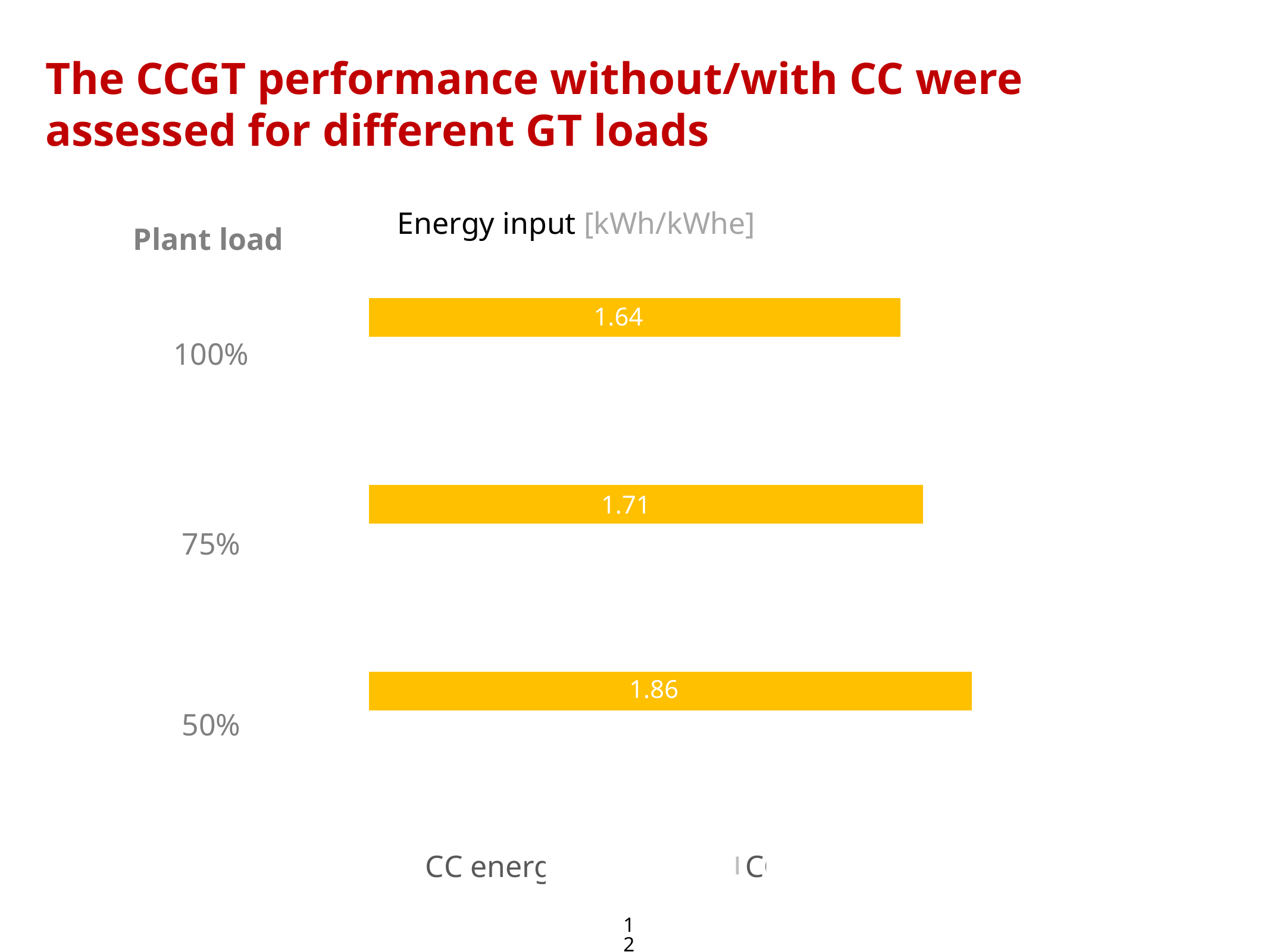
What is the energy input value for the 50% plant load? 1.86 What is the difference in energy input between the 50% and 100% plant loads? 0.22 What unit is given in the chart title for energy input? kWh/kWhe How many plant load categories are shown in the chart? 3 What is the energy input value for the 75% plant load? 1.71 What type of chart is shown on the slide? Bar chart Does the energy input rise or fall as the plant load decreases from 100% to 50%? Rises What is the energy input value for the 100% plant load? 1.64 Which plant load has the lowest energy input? 100% Which plant load has the highest energy input? 50% Which has a larger energy input, the 75% plant load or the 50% plant load? 50% What is the difference in energy input between the 75% and 100% plant loads? 0.07